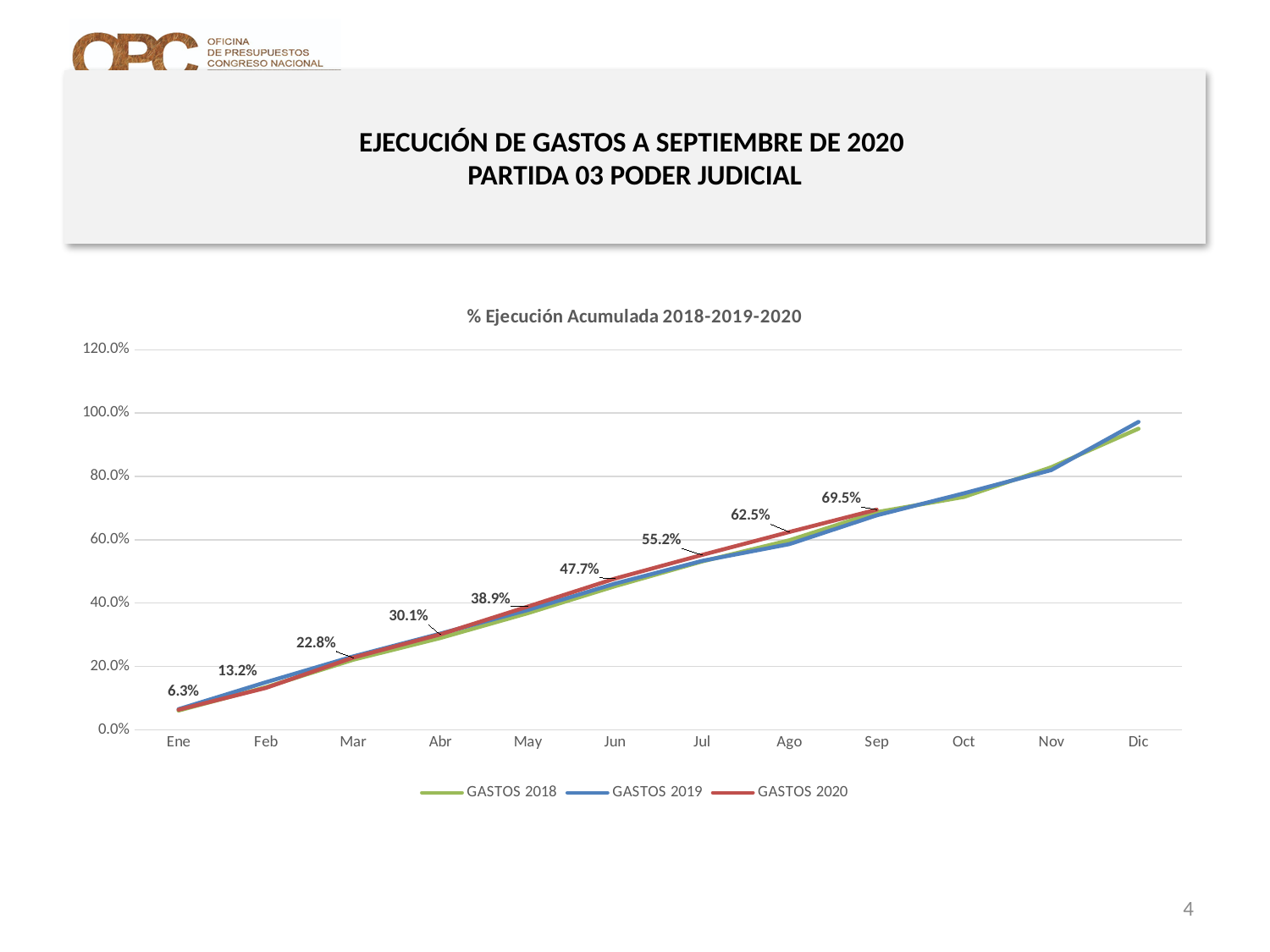
What is the value for GASTOS 2020 in Jul? 55.2% How many series does the legend list? 3 Which month has the highest labelled value for GASTOS 2020? Sep What is the difference between the GASTOS 2020 values for Mar and Feb? 9.6% What kind of chart is shown on the slide? line chart What is the difference between the GASTOS 2020 values for Sep and Ago? 7.0% Do the GASTOS 2020 values rise or fall from Ene to Sep? rise Is the value for GASTOS 2019 in Dic greater or less than 80.0%? greater What is the value for GASTOS 2020 in May? 38.9% Which month has the lowest labelled value for GASTOS 2020? Ene What is the value for GASTOS 2020 in Ene? 6.3% What is the value for GASTOS 2020 in Sep? 69.5%